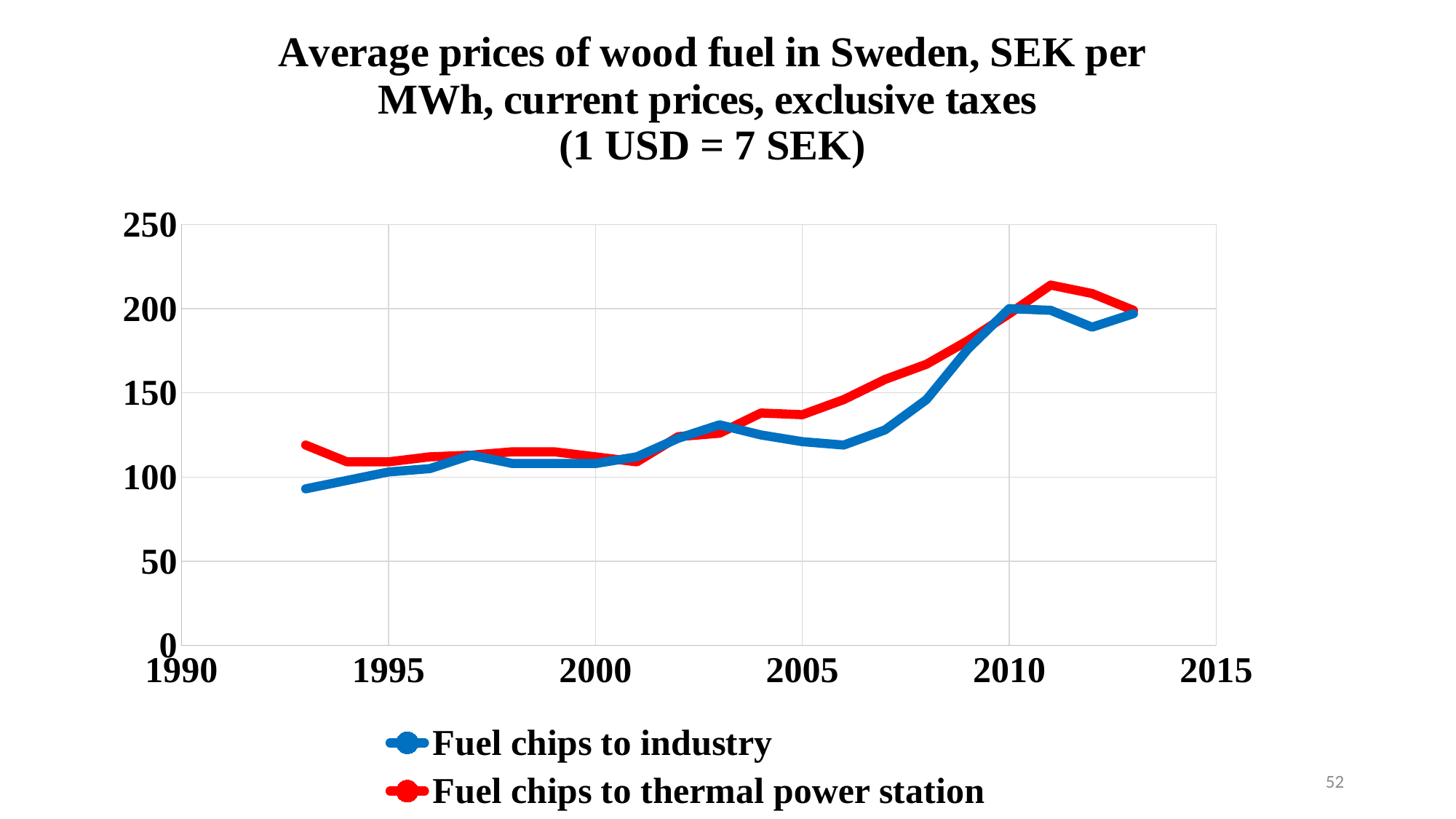
Is the value for Fuel chips to thermal power station in 2011 greater or less than 200? greater Do the prices for Fuel chips to industry generally rise or fall from 1993 to 2013? rise Is the value for Fuel chips to thermal power station in 2008 greater or less than 150? greater In 1993, which series has the higher value: Fuel chips to industry or Fuel chips to thermal power station? Fuel chips to thermal power station How many series does the legend list? 2 What kind of chart is shown on the slide? line chart Is the value for Fuel chips to industry in 1993 greater or less than 100? less In 2008, which series has the higher value: Fuel chips to industry or Fuel chips to thermal power station? Fuel chips to thermal power station What colour is the line for Fuel chips to thermal power station? red